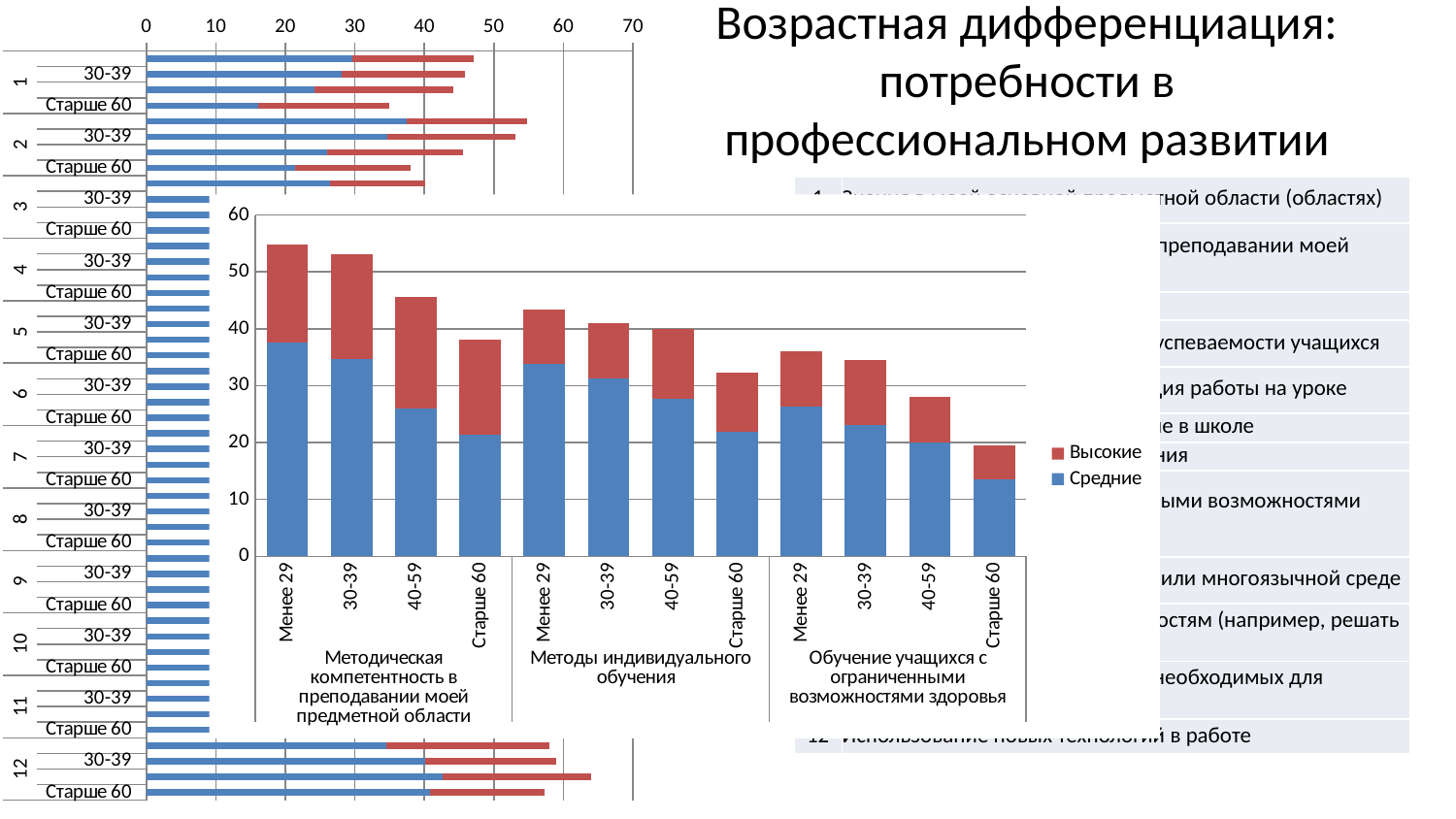
In the foreground stacked bar chart, how many bars are plotted in total? 12 In the foreground stacked bar chart, which colour represents the 'Средние' series? Blue In the foreground stacked bar chart, is the total for Старше 60 in the group 'Обучение учащихся с ограниченными возможностями здоровья' greater or less than 30? less In the foreground stacked bar chart, how many series does the legend list? 2 In the foreground stacked bar chart, which bar is the tallest overall? Менее 29 in Методическая компетентность в преподавании моей предметной области What is the highest value shown on the horizontal axis of the horizontal bar chart in the background on the left? 70 In the foreground stacked bar chart, which is larger: the total for Менее 29 in 'Методы индивидуального обучения' or the total for Менее 29 in 'Обучение учащихся с ограниченными возможностями здоровья'? Менее 29 in Методы индивидуального обучения What kind of chart is the chart in the foreground (with the legend 'Высокие' and 'Средние')? Stacked bar chart In the foreground stacked bar chart, is the total for Менее 29 in the group 'Методическая компетентность в преподавании моей предметной области' greater or less than 50? greater In the foreground stacked bar chart, do the bar totals rise or fall from Менее 29 to Старше 60 within each group? fall In the foreground stacked bar chart, is the 'Средние' value for Старше 60 in the group 'Методическая компетентность в преподавании моей предметной области' greater or less than 30? less In the foreground stacked bar chart, which bar is the shortest overall? Старше 60 in Обучение учащихся с ограниченными возможностями здоровья